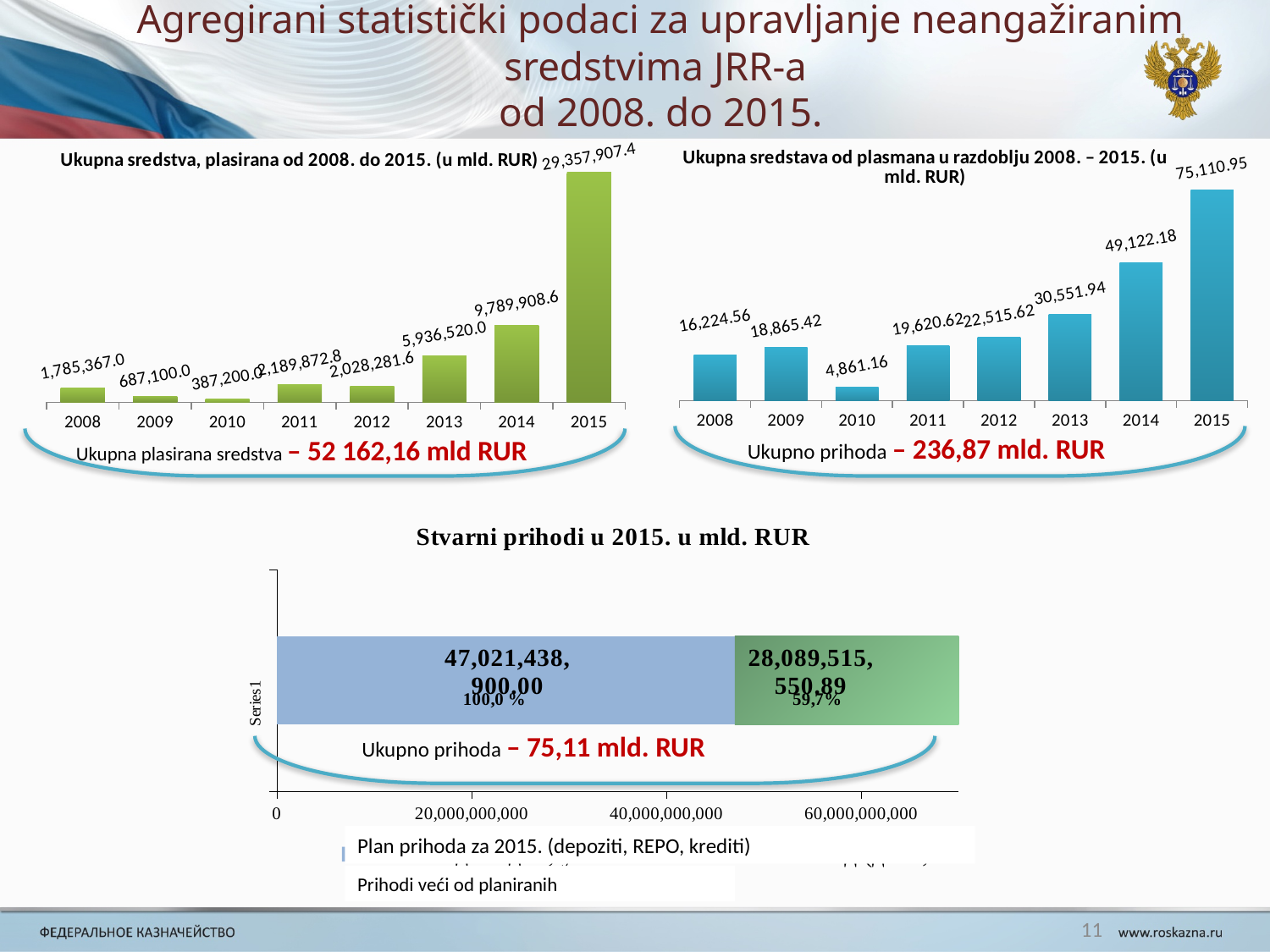
What kind of chart is 'Stvarni prihodi u 2015. u mld. RUR'? stacked bar chart In the chart 'Ukupna sredstava od plasmana u razdoblju 2008. – 2015. (u mld. RUR)', what is the difference between the values for 2015 and 2014? 25,988.77 In the chart 'Ukupna sredstva, plasirana od 2008. do 2015. (u mld. RUR)', what is the value for 2015? 29,357,907.4 In the chart 'Ukupna sredstava od plasmana u razdoblju 2008. – 2015. (u mld. RUR)', what is the value for 2010? 4,861.16 In the chart 'Ukupna sredstva, plasirana od 2008. do 2015. (u mld. RUR)', what is the value for 2014? 9,789,908.6 In the chart 'Ukupna sredstva, plasirana od 2008. do 2015. (u mld. RUR)', which is larger, the value for 2008 or the value for 2009? 2008 In the chart 'Stvarni prihodi u 2015. u mld. RUR', what is the value of the segment 'Plan prihoda za 2015. (depoziti, REPO, krediti)'? 47,021,438,900.00 How many years are shown on the x axis of the chart 'Ukupna sredstava od plasmana u razdoblju 2008. – 2015. (u mld. RUR)'? 8 In the chart 'Ukupna sredstava od plasmana u razdoblju 2008. – 2015. (u mld. RUR)', which year has the highest value? 2015 In the chart 'Ukupna sredstava od plasmana u razdoblju 2008. – 2015. (u mld. RUR)', do the values rise or fall from 2011 to 2015? rise In the chart 'Ukupna sredstva, plasirana od 2008. do 2015. (u mld. RUR)', which year has the lowest value? 2010 In the chart 'Stvarni prihodi u 2015. u mld. RUR', what is the value of the segment 'Prihodi veći od planiranih'? 28,089,515,550.89